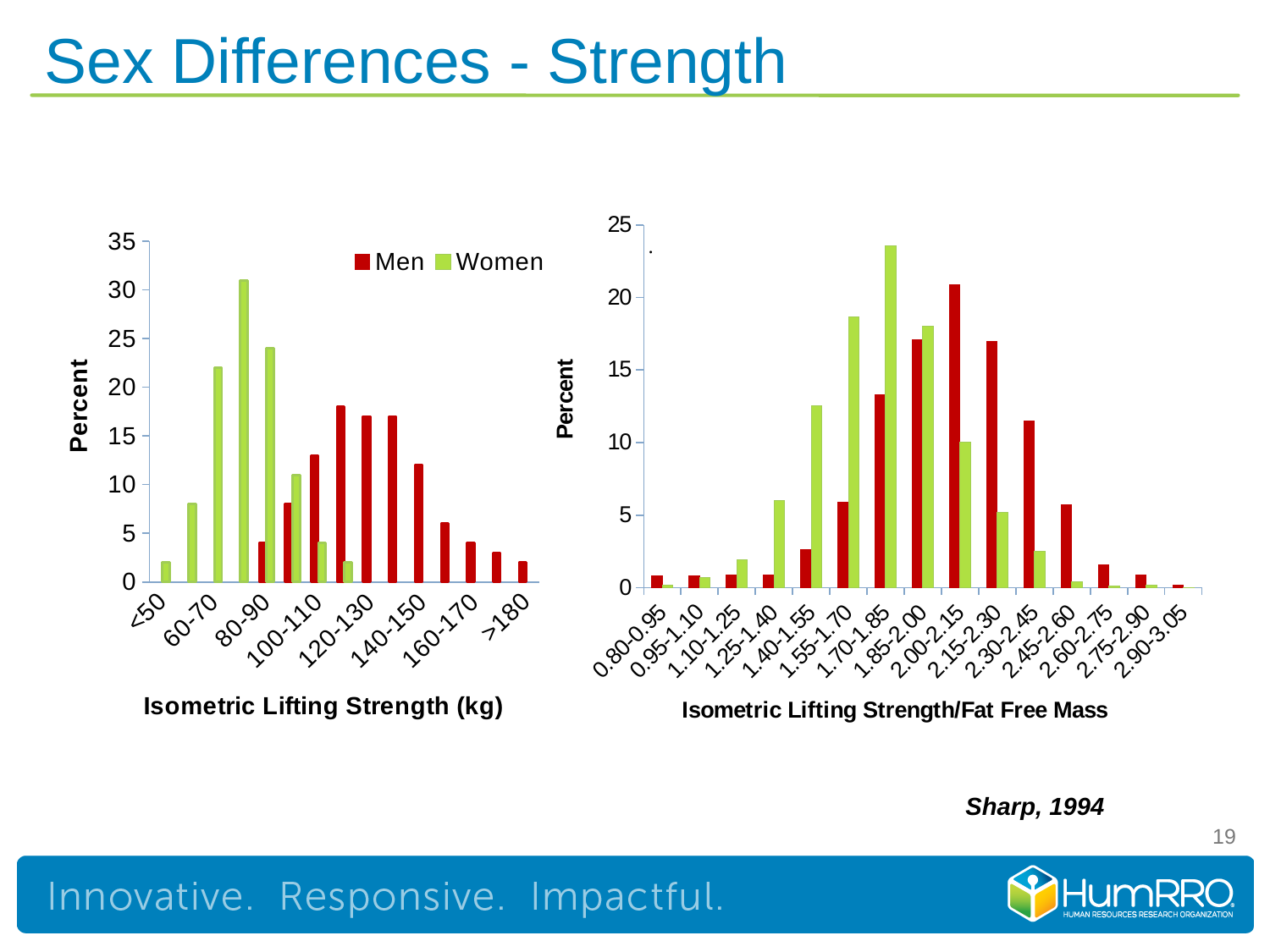
In the right chart, 'Isometric Lifting Strength/Fat Free Mass', which category has the highest Men value? 2.00-2.15 In the right chart, is the Women value for 2.30-2.45 greater or less than 5? less How many series does the legend on the left chart list? 2 What are the two series named in the legend of the left chart? Men and Women In the right chart, for the 1.70-1.85 category, which series has the larger value, Men or Women? Women In the right chart, is the Women value for 1.55-1.70 greater or less than 15? greater In the right chart, 'Isometric Lifting Strength/Fat Free Mass', which category has the highest Women value? 1.70-1.85 What is the y-axis label on the left chart? Percent In the right chart, is the Men value for 2.30-2.45 greater or less than 10? greater What kind of chart is the left chart, titled 'Isometric Lifting Strength (kg)'? bar chart In the right chart, for the 2.00-2.15 category, which series has the larger value, Men or Women? Men How many categories are labelled on the x axis of the right chart, 'Isometric Lifting Strength/Fat Free Mass'? 15